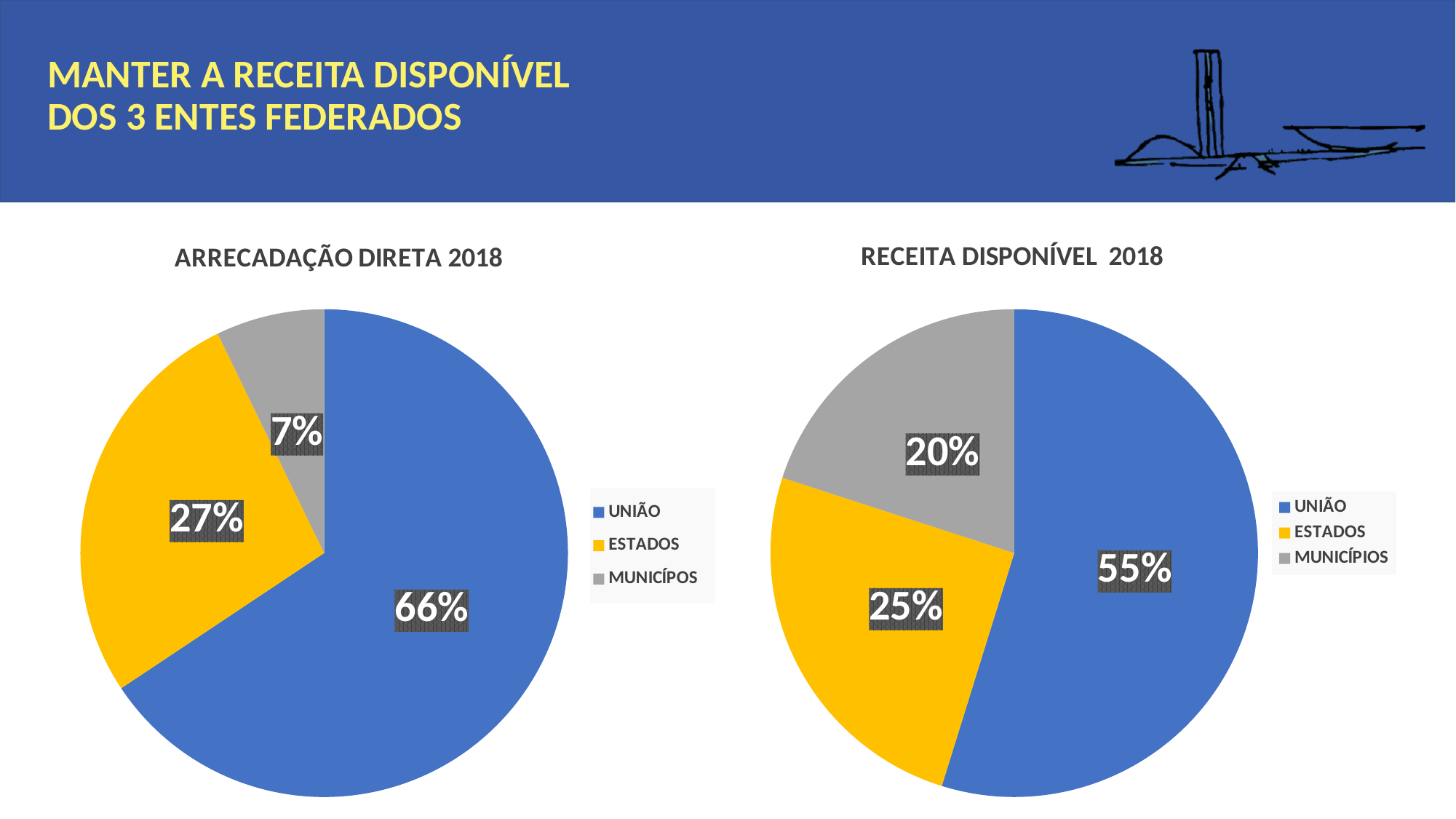
In the ARRECADAÇÃO DIRETA 2018 chart, what share does MUNICÍPOS have? 7% In the ARRECADAÇÃO DIRETA 2018 chart, what share does ESTADOS have? 27% In the RECEITA DISPONÍVEL 2018 chart, which category has the smallest slice? MUNICÍPIOS In the ARRECADAÇÃO DIRETA 2018 chart, which category has the largest slice? UNIÃO In the RECEITA DISPONÍVEL 2018 chart, what share does ESTADOS have? 25% In the RECEITA DISPONÍVEL 2018 chart, what share does UNIÃO have? 55% How many categories does the legend of the RECEITA DISPONÍVEL 2018 chart list? 3 In the RECEITA DISPONÍVEL 2018 chart, which is larger, ESTADOS or MUNICÍPIOS? ESTADOS In the ARRECADAÇÃO DIRETA 2018 chart, what is the difference between the UNIÃO and ESTADOS shares? 39% What type of chart is the ARRECADAÇÃO DIRETA 2018 chart? Pie chart In the RECEITA DISPONÍVEL 2018 chart, what share does MUNICÍPIOS have? 20% In the ARRECADAÇÃO DIRETA 2018 chart, what share does UNIÃO have? 66%